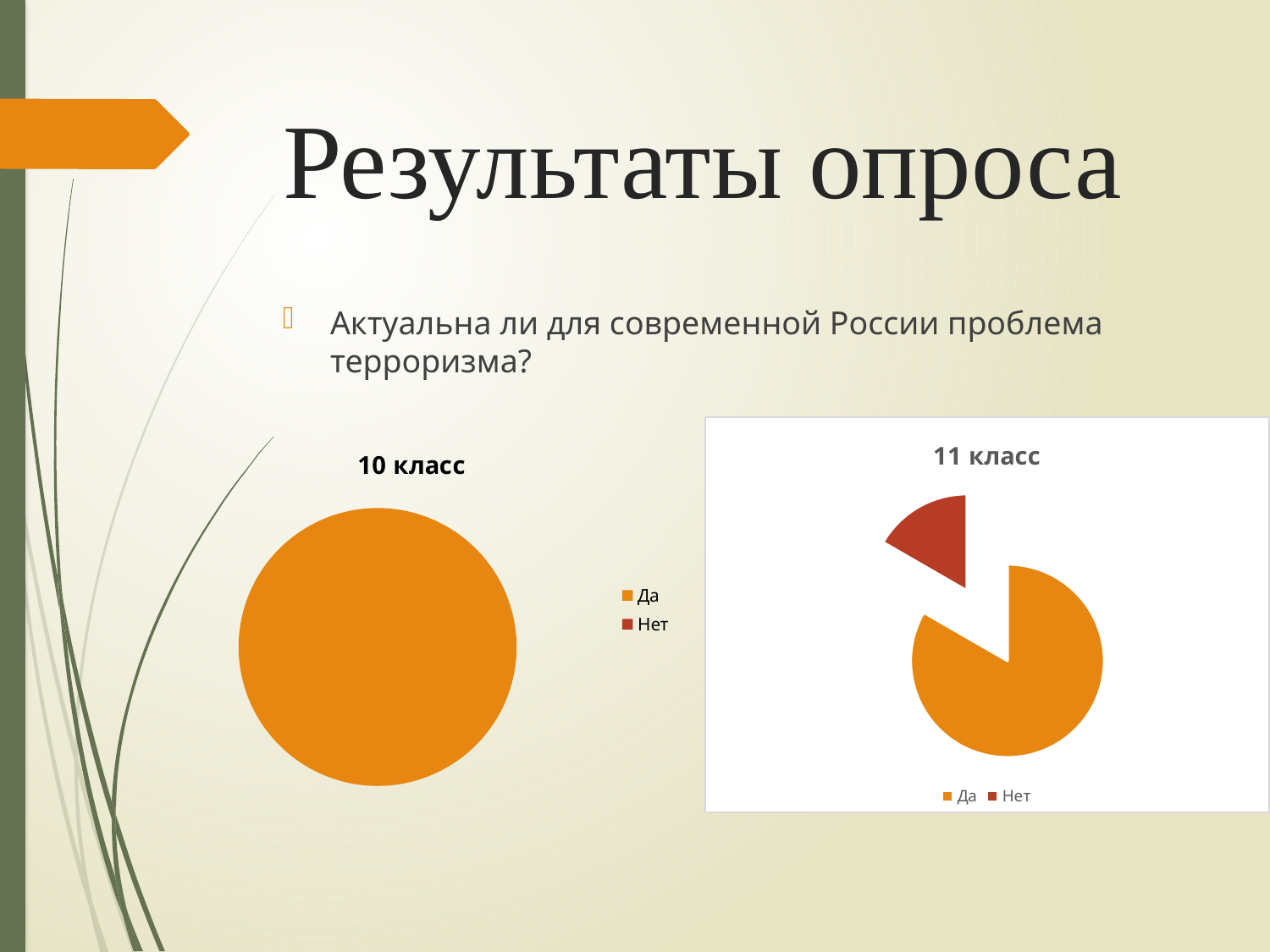
In the "11 класс" chart, is the share for Да greater or less than 50%? greater In the "11 класс" chart, is the share for Нет greater or less than 50%? less In the "11 класс" chart, which category has the smallest slice? Нет What is the title of the pie chart on the left? 10 класс What is the title of the pie chart on the right? 11 класс What kind of chart is the "11 класс" chart? pie chart What kind of chart is the "10 класс" chart? pie chart In the "10 класс" chart, which category takes up the whole pie? Да How many entries does the legend of the "10 класс" chart list? 2 How many entries does the legend of the "11 класс" chart list? 2 In the "11 класс" chart, which category has the largest slice? Да In the "11 класс" chart, which is larger, Да or Нет? Да